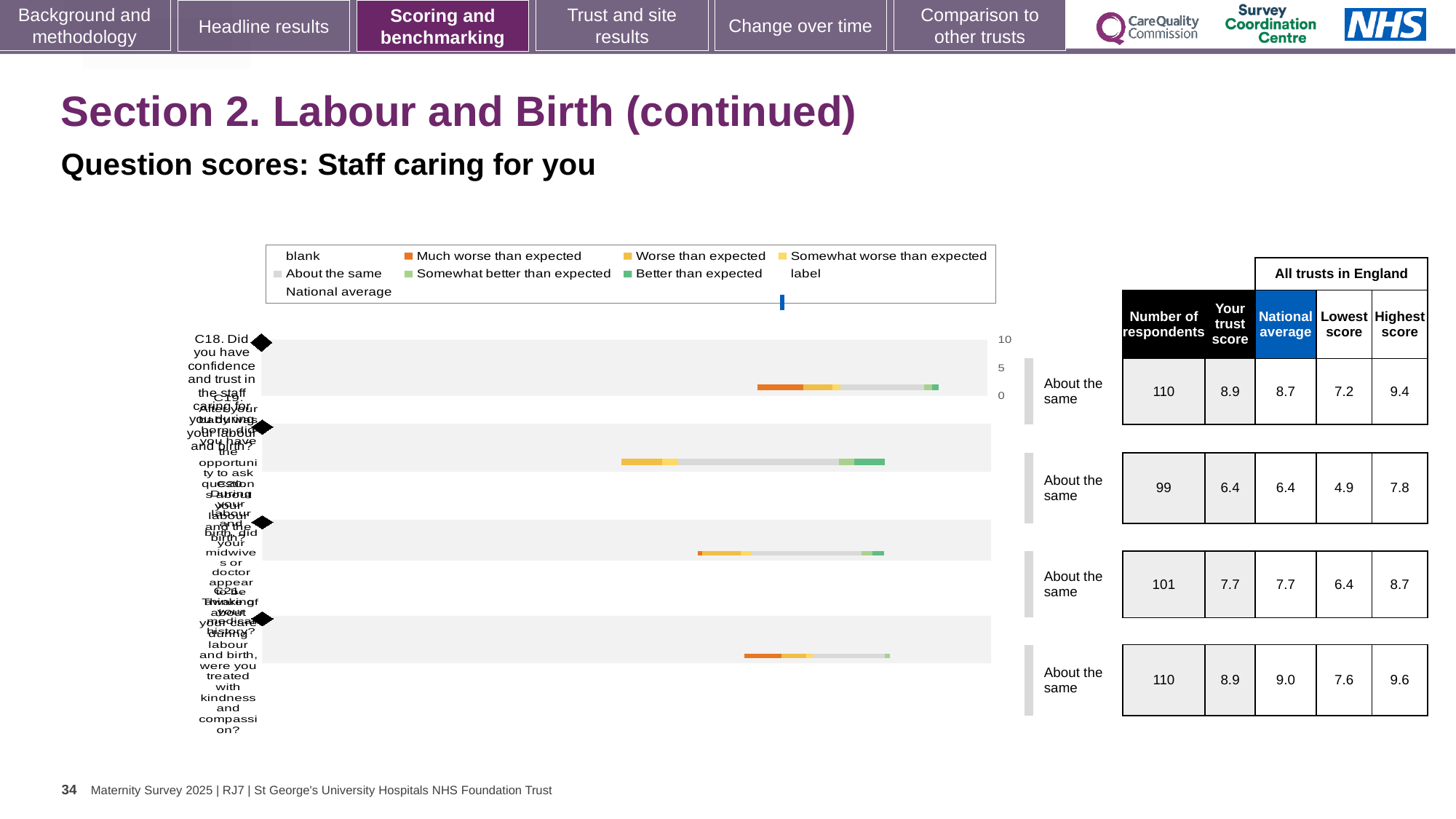
In the fourth row of the table, which is larger: 'Your trust score' or 'National average'? National average How many question rows (bars) are plotted in the chart? 4 What is the difference between the 'Highest score' and 'Lowest score' in the first row of the table? 2.2 In the table, what is the 'Lowest score' for the second row? 4.9 What kind of chart is shown on the slide? bar chart In the table, what is the 'Number of respondents' for the third row? 101 What is the subtitle of the chart section on the slide? Question scores: Staff caring for you In the table, what is the 'Highest score' for the fourth row? 9.6 Which row has the lowest 'Your trust score' in the table? the second row (6.4) In the table, what is the 'Your trust score' for the first row? 8.9 What benchmark category is shown next to every bar in the chart? About the same In the table, what is the 'National average' for the second row? 6.4